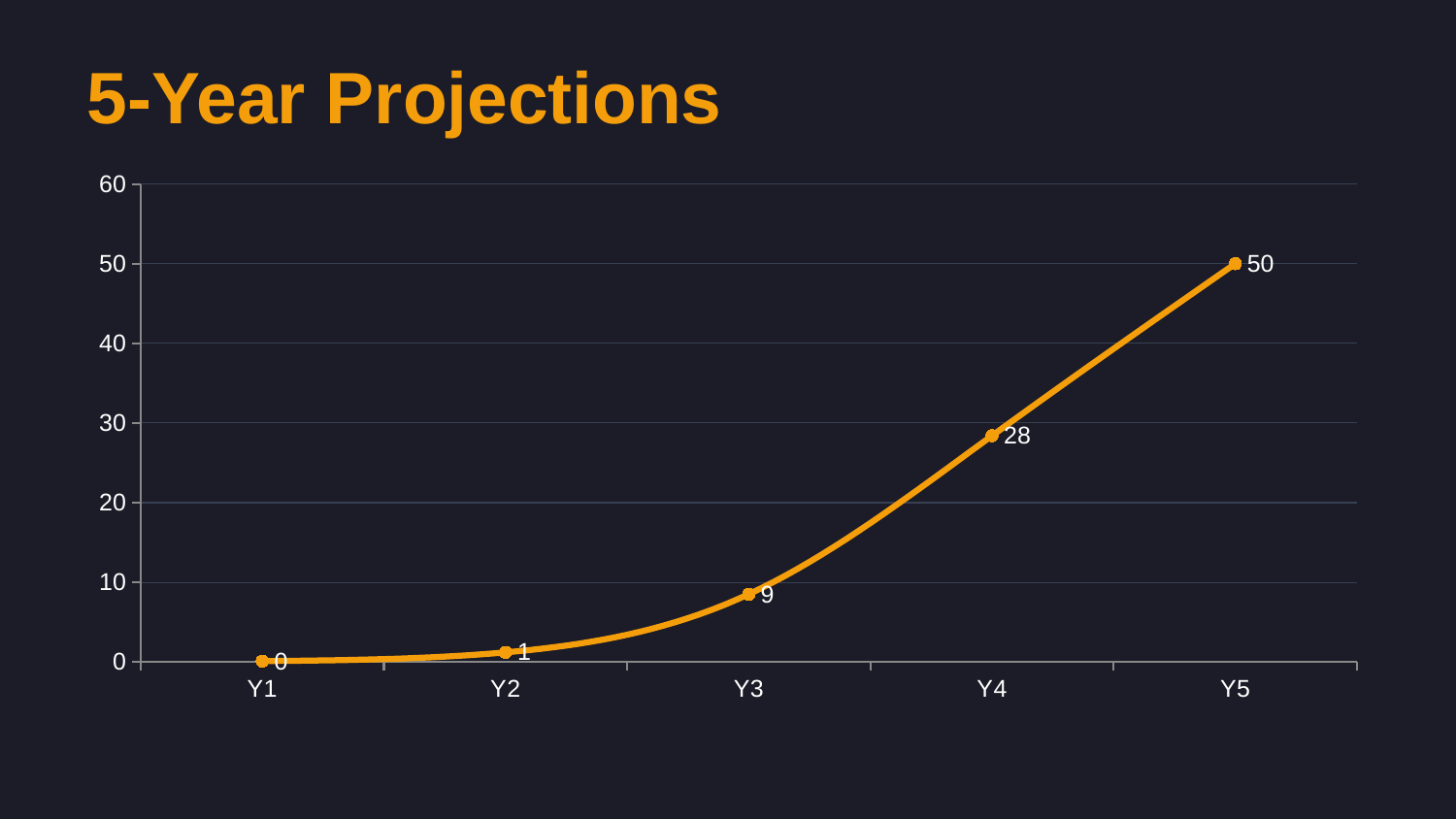
What is the value for Y3? 9 What kind of chart is shown on the slide? Line chart What is the value for Y5? 50 What is the difference between the values for Y5 and Y4? 22 What is the difference between the values for Y3 and Y2? 8 How many data points are plotted on the chart? 5 What is the value for Y1? 0 Which year has the lowest value? Y1 Do the values rise or fall from Y1 to Y5? Rise Which is larger, the value for Y4 or the value for Y3? Y4 Which year has the highest value? Y5 What is the value for Y4? 28